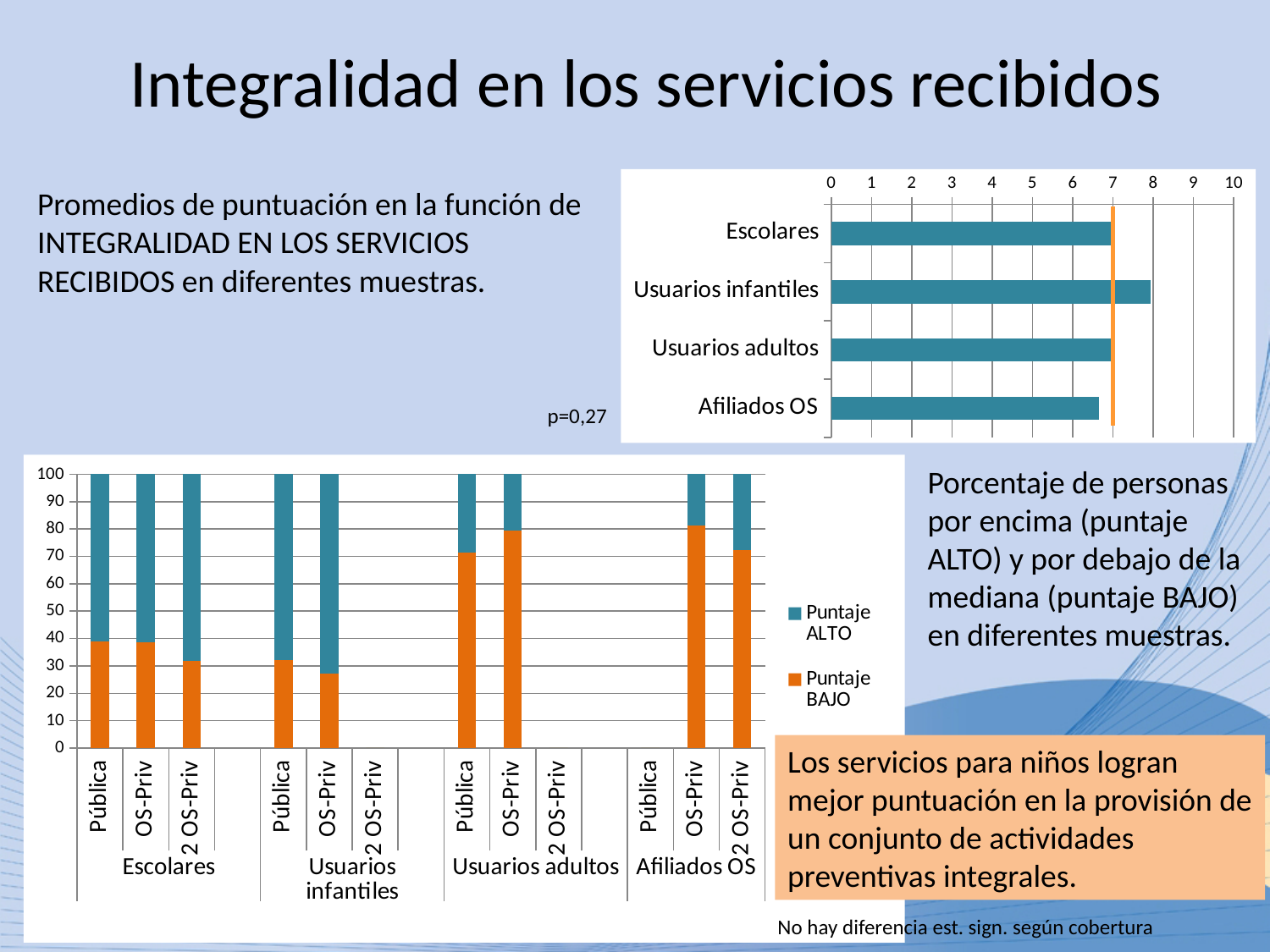
What kind of chart is the top-right chart? bar chart In the top-right chart, how many categories are plotted? 4 In the bottom-left chart, which has the larger Puntaje BAJO value: Pública under Escolares or Pública under Usuarios adultos? Pública under Usuarios adultos In the bottom-left chart, how many series does the legend list? 2 In the top-right chart, is the value for Afiliados OS greater or less than 7? less In the bottom-left chart, which colour represents Puntaje BAJO? orange In the bottom-left chart, what are the two legend entries? Puntaje ALTO and Puntaje BAJO In the top-right chart, is the value for Usuarios infantiles greater or less than 7? greater In the bottom-left chart, is the Puntaje BAJO value for OS-Priv under Usuarios infantiles greater or less than 30? less In the top-right chart, which category has the highest value? Usuarios infantiles In the top-right chart, which category has the lowest value? Afiliados OS